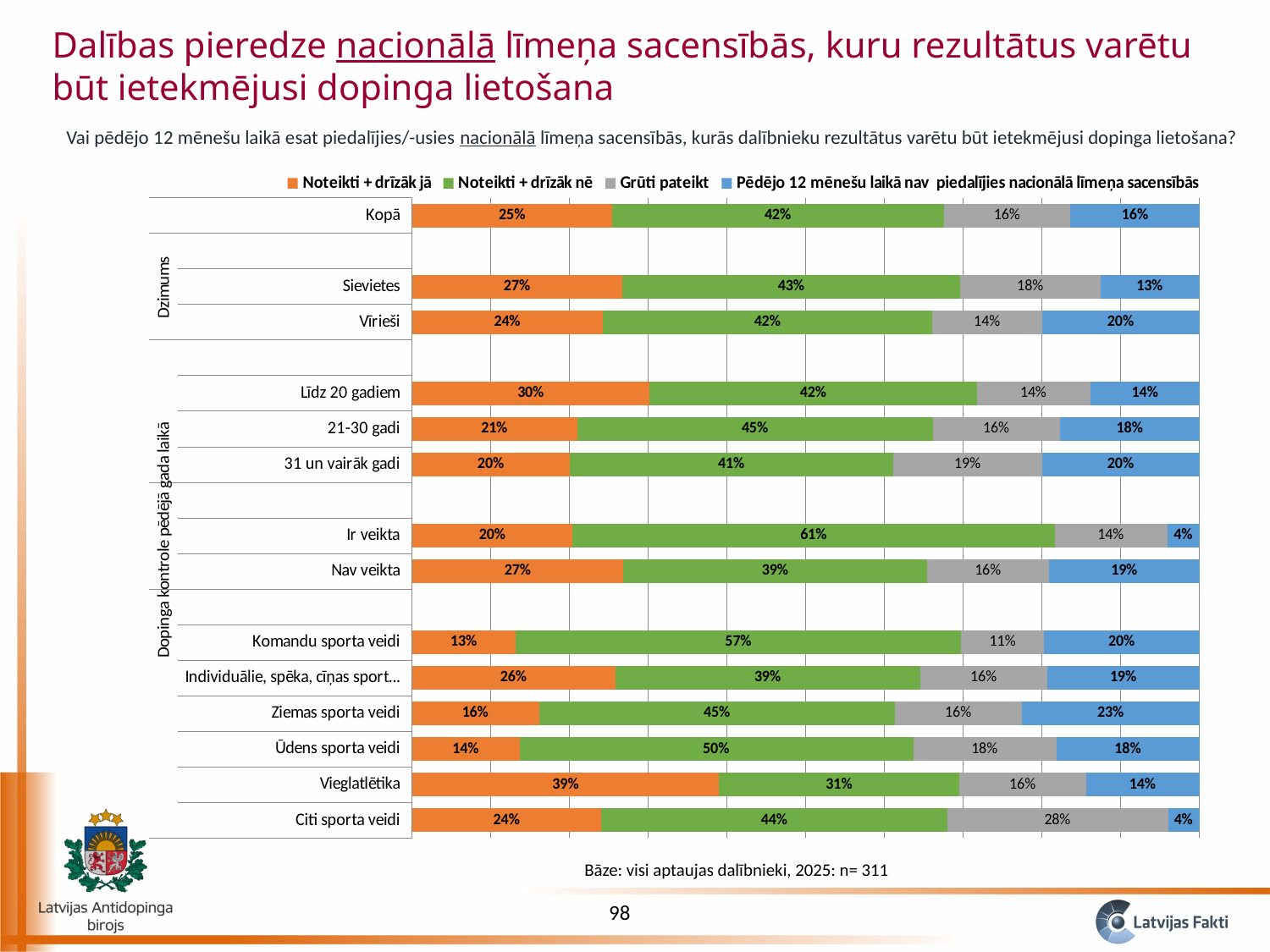
Which category has the lowest value for "Noteikti + drīzāk jā"? Komandu sporta veidi What is the difference between the "Noteikti + drīzāk jā" values for Sievietes and Vīrieši? 3% How many series does the legend list? 4 What is the value of "Pēdējo 12 mēnešu laikā nav piedalījies nacionālā līmeņa sacensībās" for Ziemas sporta veidi? 23% What is the value of "Grūti pateikt" for Citi sporta veidi? 28% What is the value of "Noteikti + drīzāk nē" for Ir veikta? 61% How many categories are plotted on the chart? 14 Which category has the highest value for "Noteikti + drīzāk nē"? Ir veikta Which is larger: the "Noteikti + drīzāk nē" value for Komandu sporta veidi or for Ūdens sporta veidi? Komandu sporta veidi What kind of chart is shown on the slide? Stacked bar chart Which category has the highest value for "Noteikti + drīzāk jā"? Vieglatlētika What is the value of "Noteikti + drīzāk jā" for Kopā? 25%